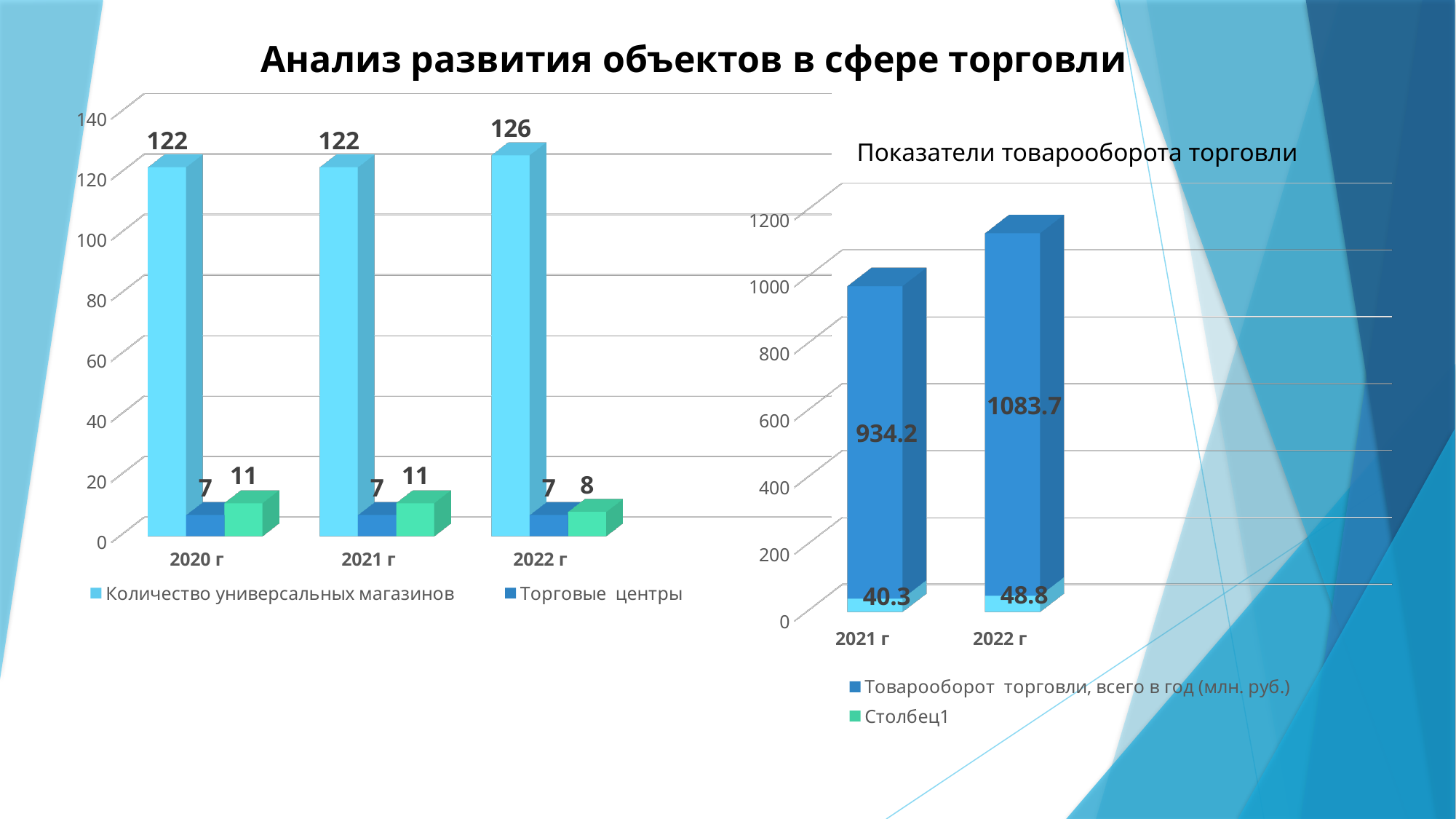
In the left chart, which year has the highest value for Количество универсальных магазинов? 2022 г In the chart titled Показатели товарооборота торговли, what is the total of the stacked bar for 2022 г? 1132.5 In the chart titled Показатели товарооборота торговли, does the Товарооборот торговли value rise or fall from 2021 г to 2022 г? Rise In the left chart, what is the value for Торговые центры in 2021 г? 7 What kind of chart is the left chart? Bar chart In the chart titled Показатели товарооборота торговли, what is the difference between the Товарооборот торговли values for 2022 г and 2021 г? 149.5 In the left chart, how many series does the legend list? 2 In the left chart, what is the difference between the Количество универсальных магазинов values for 2022 г and 2021 г? 4 In the left chart, how many year categories are shown on the x axis? 3 In the left chart, what is the value for Количество универсальных магазинов in 2022 г? 126 In the chart titled Показатели товарооборота торговли, what is the value of Товарооборот торговли, всего в год (млн. руб.) for 2022 г? 1083.7